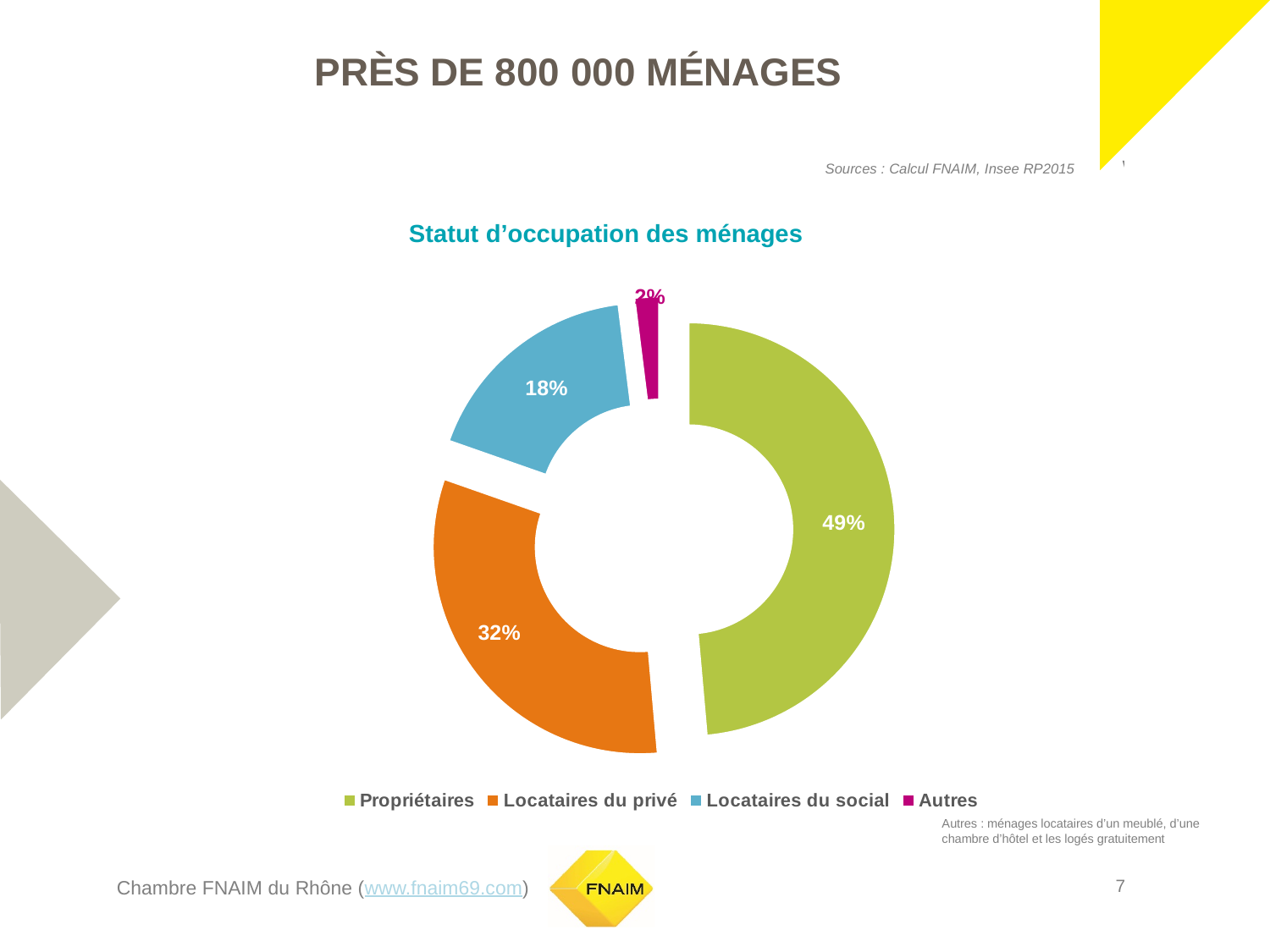
Which is larger, the share of Locataires du social or the share of Autres? Locataires du social What is the difference in percentage points between Propriétaires and Locataires du privé? 17 What is the title of the chart? Statut d'occupation des ménages Which occupancy status has the largest share? Propriétaires What is the difference in percentage points between Locataires du privé and Locataires du social? 14 What share of households fall under Autres? 2% What share of households are Locataires du privé? 32% What share of households are Propriétaires? 49% How many categories does the chart show? 4 Which occupancy status has the smallest share? Autres What share of households are Locataires du social? 18% What kind of chart is shown on the slide? Pie chart (doughnut)